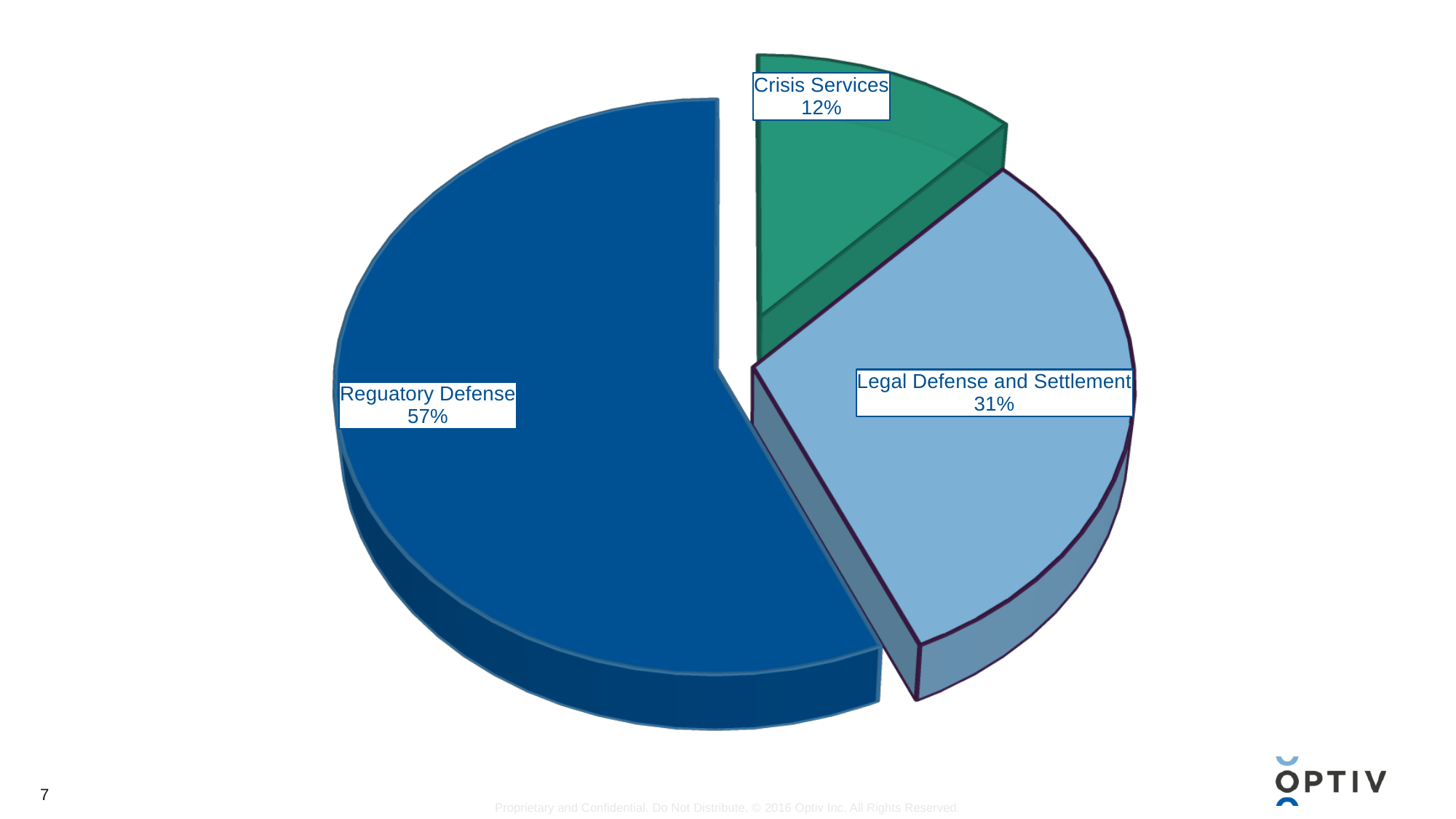
What percentage does the Legal Defense and Settlement slice represent? 31% Which slice of the pie is the smallest? Crisis Services What percentage does the Reguatory Defense slice represent? 57% What is the difference in percentage points between Legal Defense and Settlement and Crisis Services? 19 How many slices does the pie chart have? 3 What kind of chart is shown on the slide? pie chart Which slice is pulled out (exploded) from the rest of the pie? Legal Defense and Settlement What colour is the Crisis Services slice? green What is the difference in percentage points between Reguatory Defense and Legal Defense and Settlement? 26 Which slice of the pie is the largest? Reguatory Defense What percentage does the Crisis Services slice represent? 12% Which is larger, Legal Defense and Settlement or Crisis Services? Legal Defense and Settlement